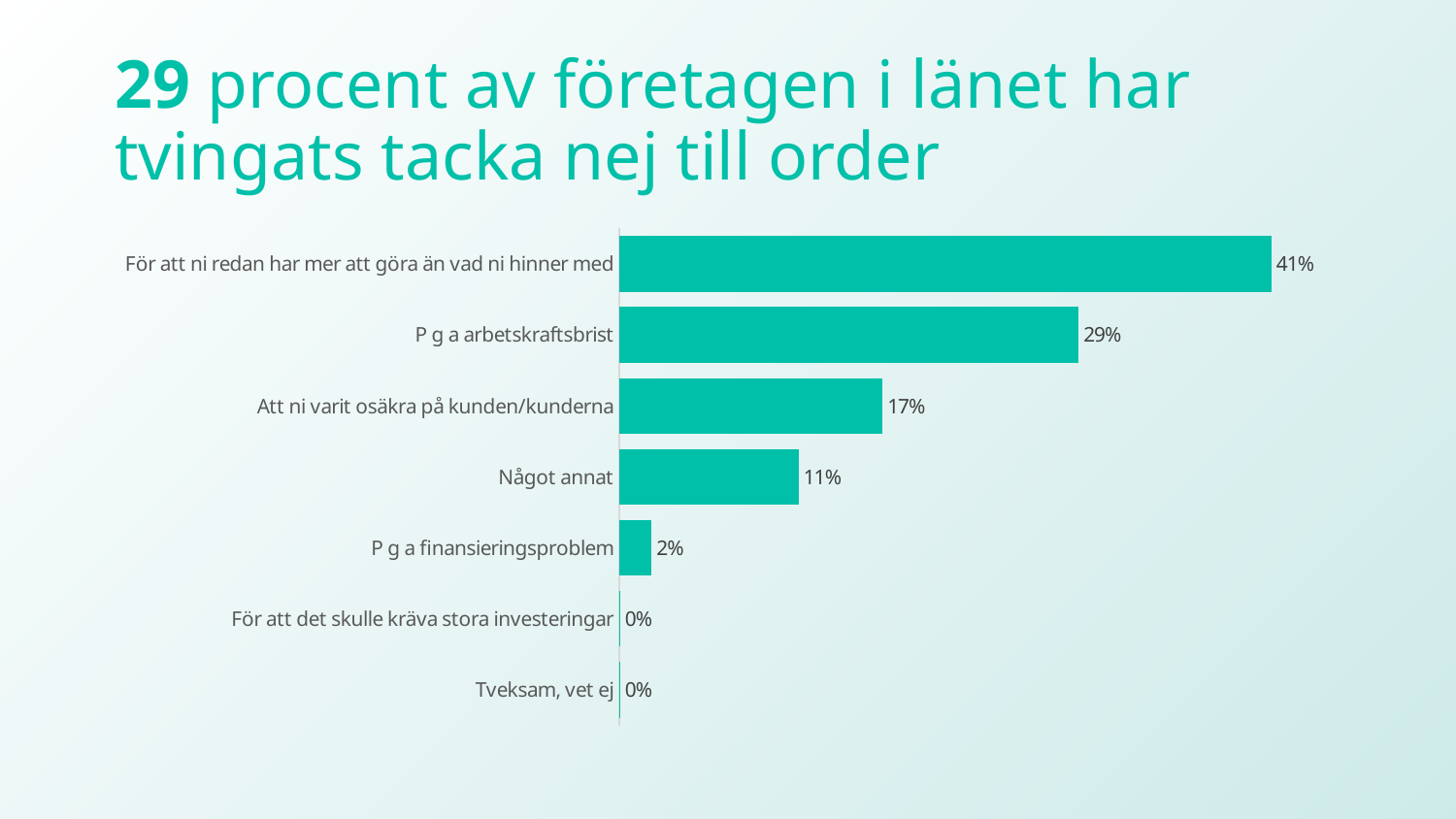
What kind of chart is shown on the slide? Bar chart How many categories have a value of 0%? 2 What is the value for "Något annat"? 11% Which is larger, the value for "Något annat" or the value for "P g a finansieringsproblem"? Något annat What colour are the bars in the chart? Teal How many categories are shown in the chart? 7 What is the difference between the values for "För att ni redan har mer att göra än vad ni hinner med" and "P g a arbetskraftsbrist"? 12% What is the value for "P g a finansieringsproblem"? 2% Which category has the highest value? För att ni redan har mer att göra än vad ni hinner med What is the difference between the values for "Att ni varit osäkra på kunden/kunderna" and "Något annat"? 6% What is the value for "Att ni varit osäkra på kunden/kunderna"? 17% What is the value for "P g a arbetskraftsbrist"? 29%